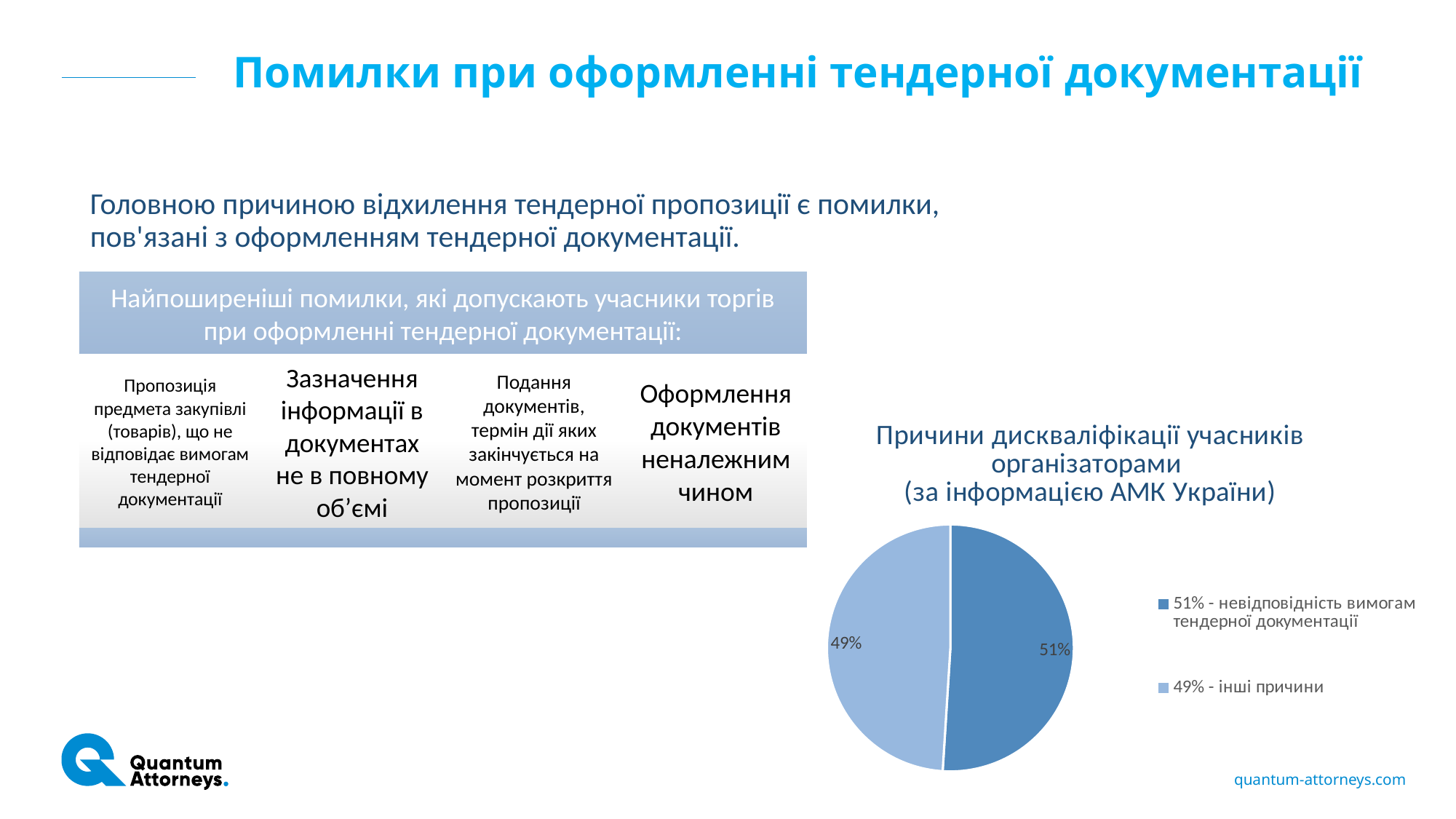
How many slices does the pie chart have? 2 How many entries does the legend of the pie chart list? 2 Which slice of the pie chart is the smallest? інші причини Which slice of the pie chart is the largest? невідповідність вимогам тендерної документації What share of the pie is labelled for 'невідповідність вимогам тендерної документації'? 51% Which is larger: the share for 'невідповідність вимогам тендерної документації' or the share for 'інші причини'? невідповідність вимогам тендерної документації By how many percentage points does the 'невідповідність вимогам тендерної документації' slice exceed the 'інші причини' slice? 2 What share of the pie is labelled for 'інші причини'? 49% What is the title of the pie chart? Причини дискваліфікації учасників організаторами (за інформацією АМК України) Which slice of the pie chart is drawn in the darker blue colour? 51% - невідповідність вимогам тендерної документації What kind of chart is shown on the slide? pie chart